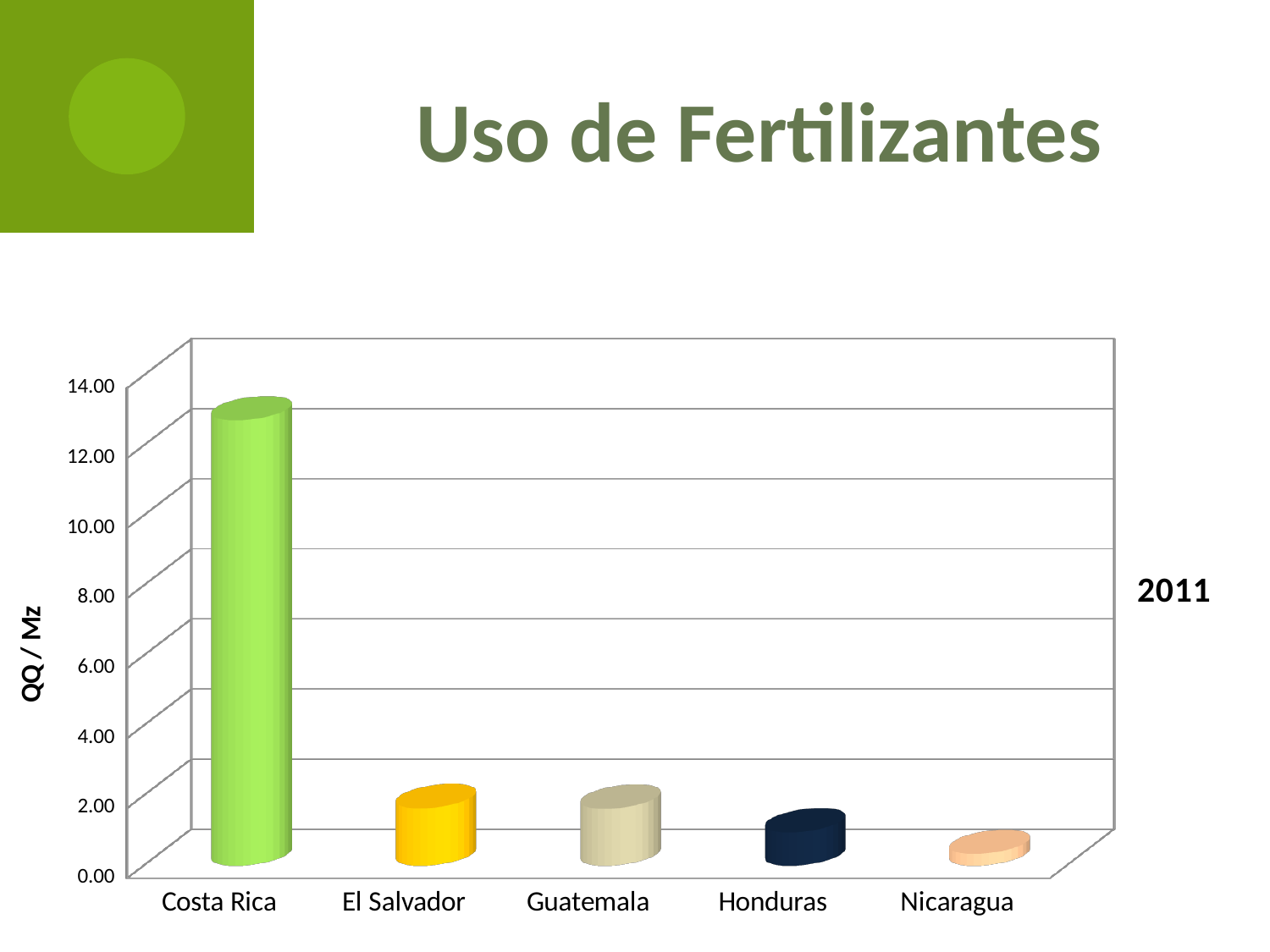
Which country has the highest fertilizer use in the chart? Costa Rica Is the value for Honduras greater or less than 4.00? less What is the label on the vertical axis of the chart? QQ / Mz How many countries are shown on the x axis of the chart? 5 Which country has the lowest fertilizer use in the chart? Nicaragua Is the value for Costa Rica greater or less than 12.00? greater What kind of chart is shown on the slide? bar chart Which is larger, the value for Honduras or the value for Nicaragua? Honduras Is the value for Nicaragua greater or less than 2.00? less Which is larger, the value for Costa Rica or the value for Honduras? Costa Rica